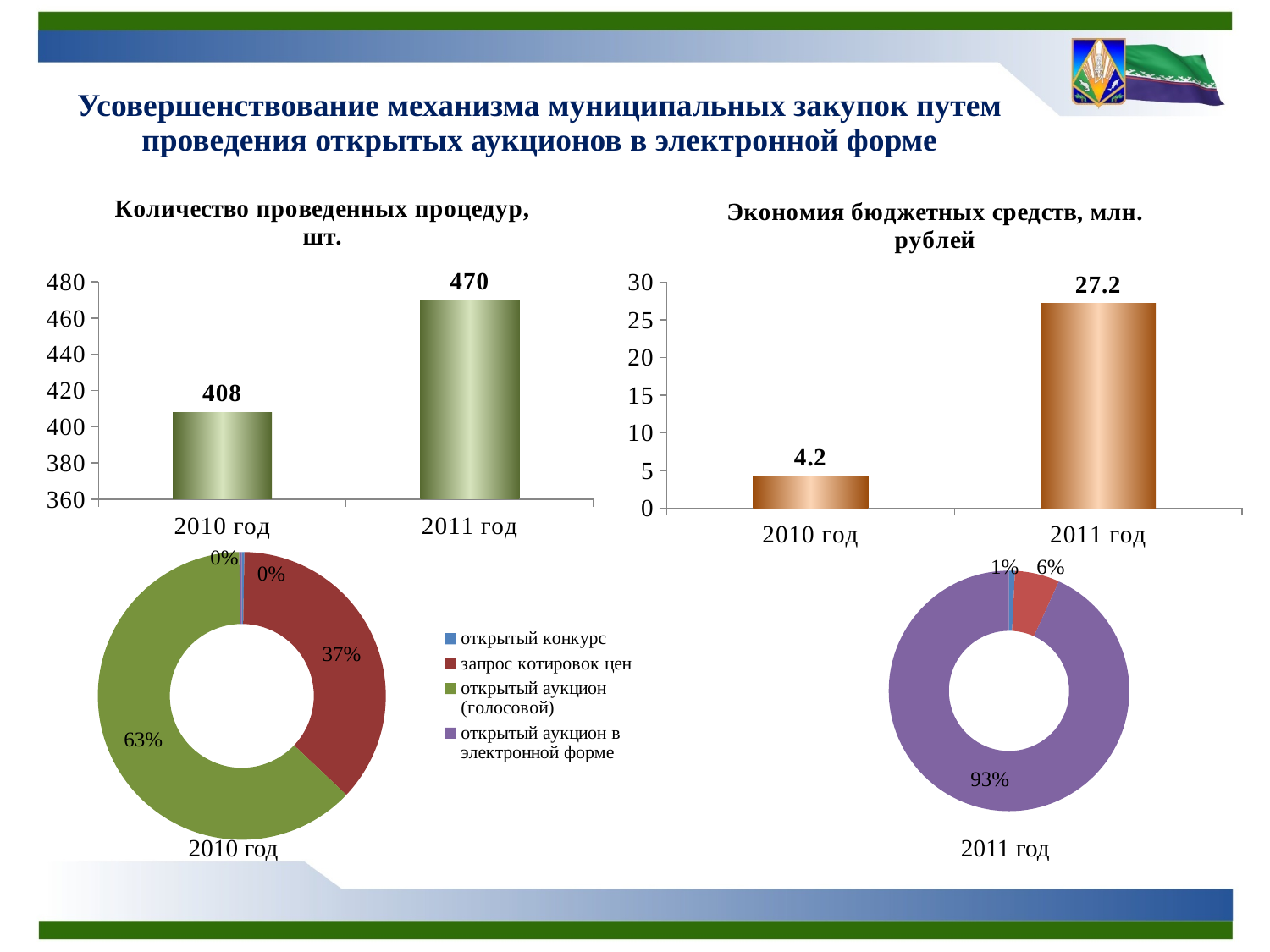
In the chart titled "Количество проведенных процедур, шт.", what is the value for 2010 год? 408 In the bottom-right doughnut chart labelled "2011 год", what share does "открытый аукцион в электронной форме" have? 93% In the bottom-left doughnut chart labelled "2010 год", what share does "открытый аукцион (голосовой)" have? 63% In the bottom-left doughnut chart labelled "2010 год", what share does "запрос котировок цен" have? 37% In the chart titled "Экономия бюджетных средств, млн. рублей", what is the difference between the 2011 год and 2010 год values? 23 In the chart titled "Экономия бюджетных средств, млн. рублей", which year has the higher value? 2011 год In the chart titled "Экономия бюджетных средств, млн. рублей", what is the value for 2011 год? 27.2 What kind of chart is the one titled "Количество проведенных процедур, шт."? bar chart In the chart titled "Количество проведенных процедур, шт.", what is the difference between the values for 2011 год and 2010 год? 62 In the chart titled "Количество проведенных процедур, шт.", what is the value for 2011 год? 470 In the chart titled "Экономия бюджетных средств, млн. рублей", what is the value for 2010 год? 4.2 How many entries does the legend between the two doughnut charts list? 4